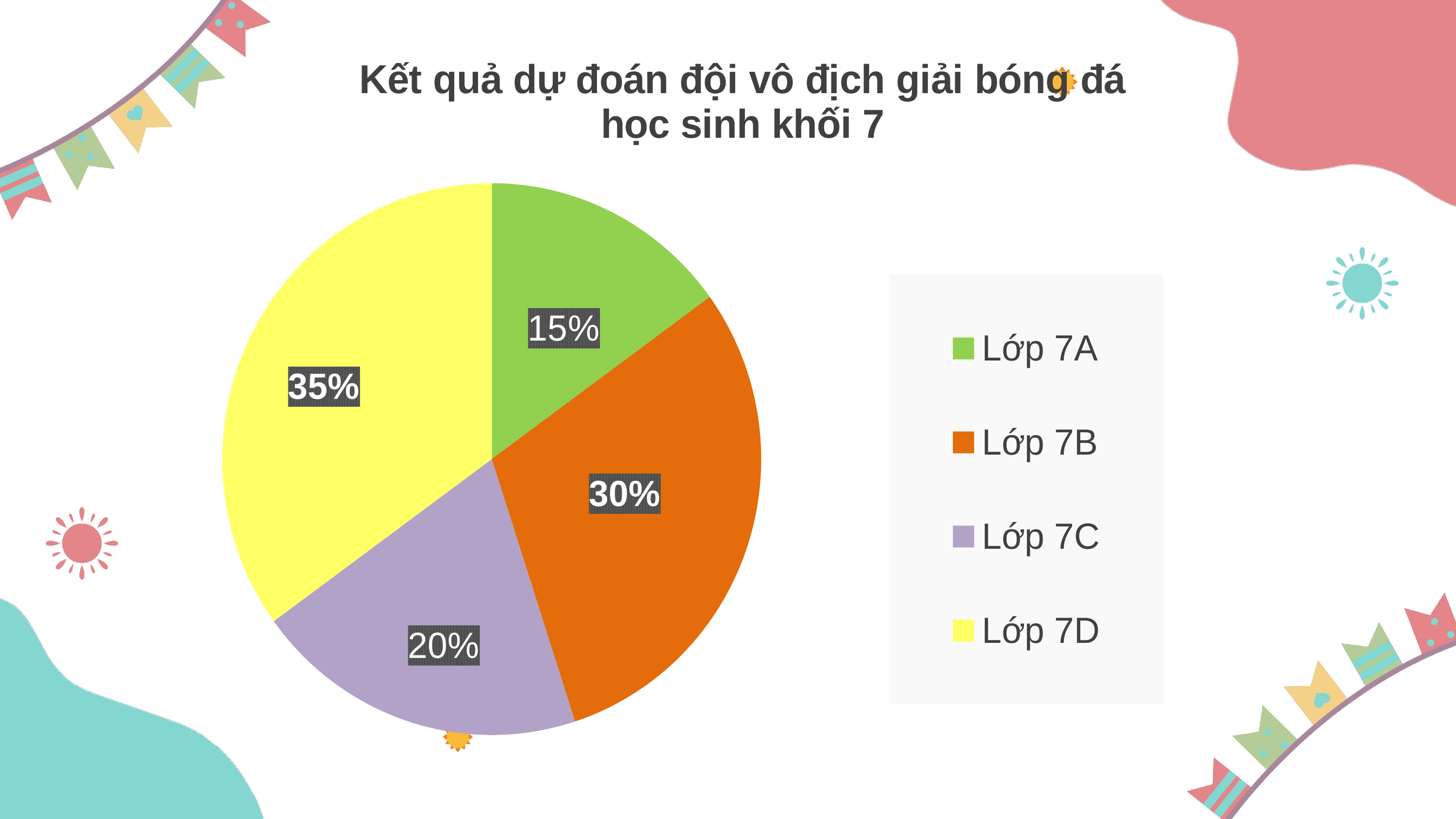
What percentage of the pie is Lớp 7B? 30% Which is larger, the share for Lớp 7B or the share for Lớp 7C? Lớp 7B How many slices does the pie chart have? 4 What kind of chart is shown on the slide? Pie chart What is the difference in percentage points between Lớp 7D and Lớp 7A? 20% Which class has the smallest share of the pie? Lớp 7A Which class has the largest share of the pie? Lớp 7D What percentage of the pie is Lớp 7D? 35% What percentage of the pie is Lớp 7A? 15% Which colour represents Lớp 7C in the legend? Purple What percentage of the pie is Lớp 7C? 20% What is the combined share of Lớp 7B and Lớp 7C? 50%